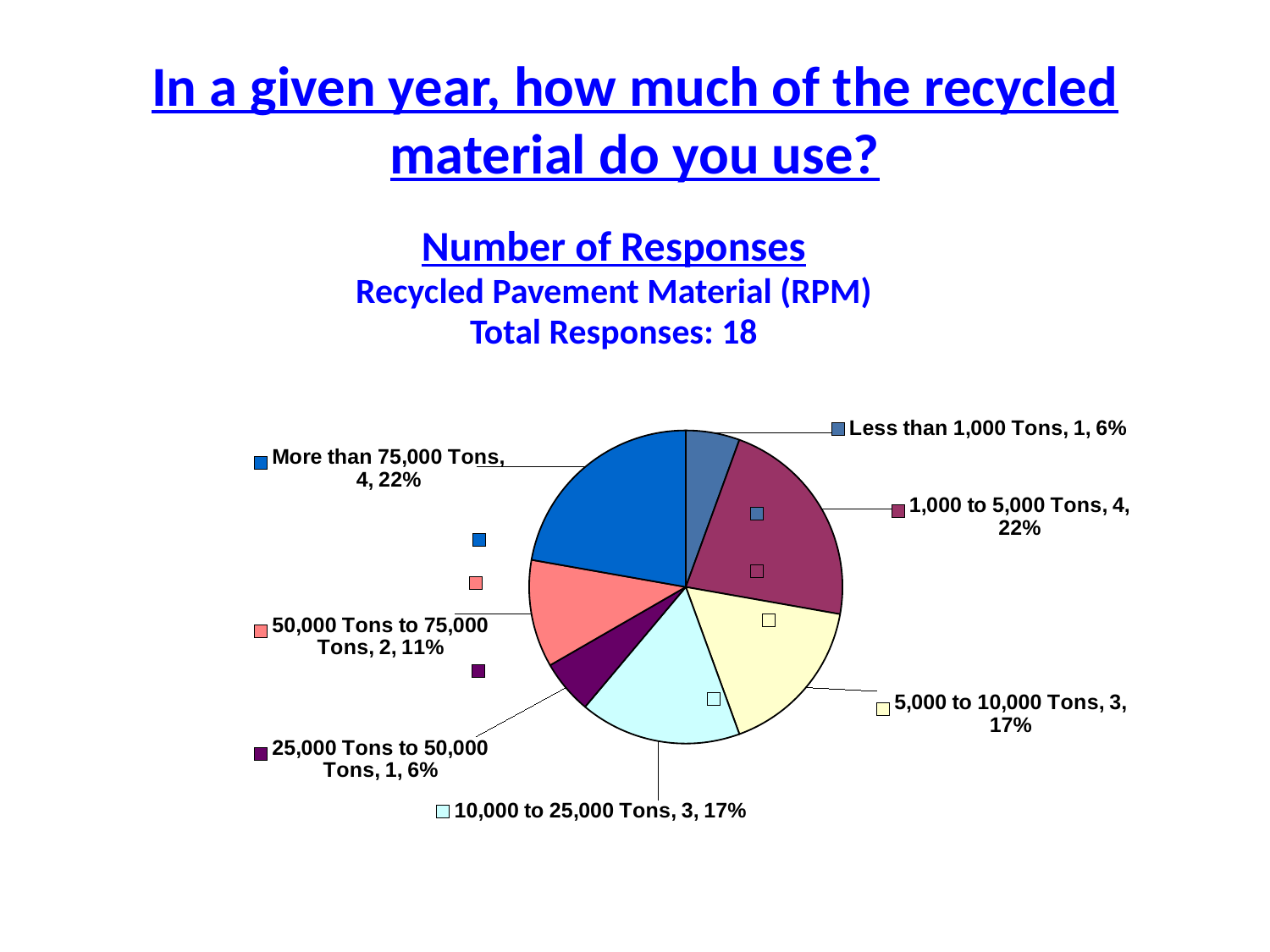
How many responses are in the "Less than 1,000 Tons" category? 1 What share of the pie does the "More than 75,000 Tons" slice represent? 22% What share of the pie does the "5,000 to 10,000 Tons" slice represent? 17% What is the total number of responses shown for the chart? 18 How many responses are in the "50,000 Tons to 75,000 Tons" category? 2 What type of chart is shown on the slide? pie chart What is the difference in number of responses between "1,000 to 5,000 Tons" and "10,000 to 25,000 Tons"? 1 How many categories (slices) does the pie chart have? 7 How many responses are in the "1,000 to 5,000 Tons" category? 4 Which has more responses: "50,000 Tons to 75,000 Tons" or "25,000 Tons to 50,000 Tons"? 50,000 Tons to 75,000 Tons Which recycled material does the chart cover, according to the subtitle? Recycled Pavement Material (RPM) What share of the pie does the "25,000 Tons to 50,000 Tons" slice represent? 6%